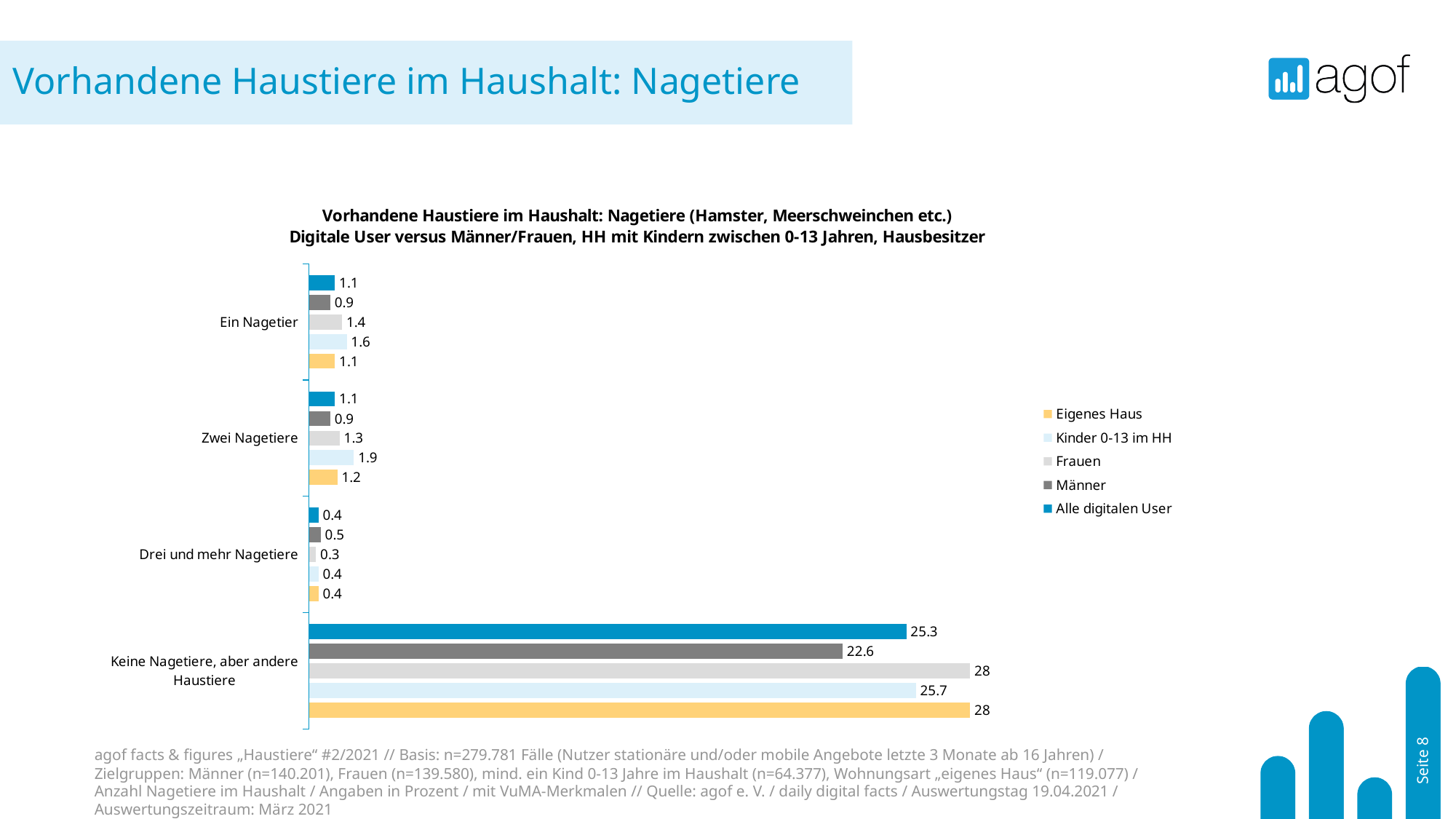
Which series has the lowest value in the category Keine Nagetiere, aber andere Haustiere? Männer Which series has the highest value in the category Zwei Nagetiere? Kinder 0-13 im HH How many series does the legend list? 5 What kind of chart is shown on the slide? bar chart What is the difference between the Alle digitalen User value and the Männer value in the category Keine Nagetiere, aber andere Haustiere? 2.7 How many categories are shown on the chart? 4 What is the value for Alle digitalen User in the category Ein Nagetier? 1.1 In the category Ein Nagetier, which is larger: the value for Frauen or the value for Männer? Frauen What is the value for Männer in the category Keine Nagetiere, aber andere Haustiere? 22.6 Which series is shown in yellow in the legend? Eigenes Haus What is the value for Frauen in the category Drei und mehr Nagetiere? 0.3 What is the value for Kinder 0-13 im HH in the category Zwei Nagetiere? 1.9